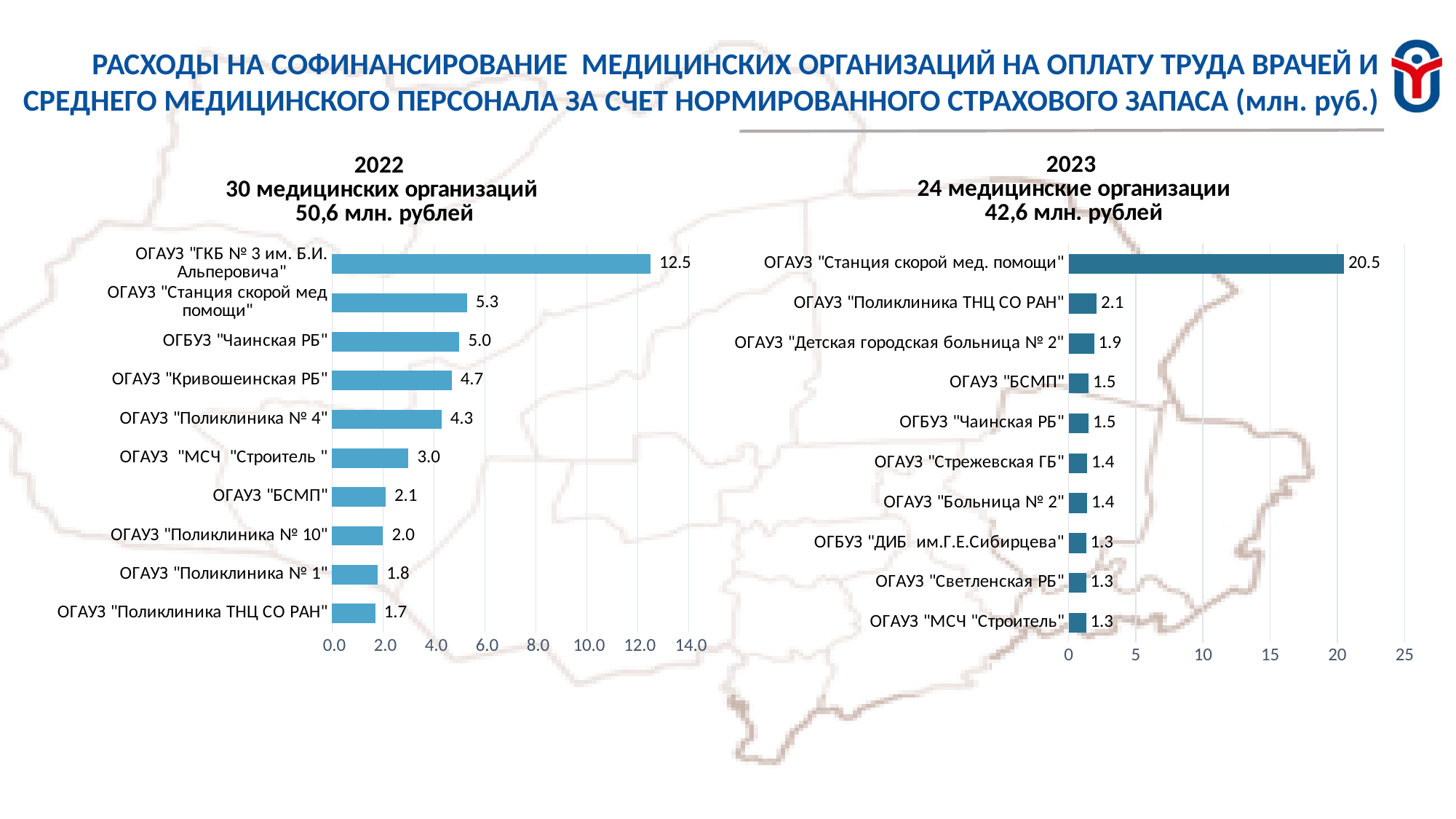
In the 2023 chart, what is the value for ОГАУЗ "Поликлиника ТНЦ СО РАН"? 2.1 In the 2023 chart, is the value for ОГАУЗ "Станция скорой мед. помощи" greater or less than 20? greater In the 2022 chart, what is the value for ОГАУЗ "Станция скорой мед помощи"? 5.3 According to the 2023 chart heading, how many medical organisations were covered in 2023? 24 In the 2022 chart, what is the difference between ОГБУЗ "Чаинская РБ" and ОГАУЗ "Кривошеинская РБ"? 0.3 In the 2022 chart, which organisation has the highest value? ОГАУЗ "ГКБ № 3 им. Б.И. Альперовича" In the 2022 chart, which is larger: ОГАУЗ "МСЧ "Строитель" or ОГАУЗ "БСМП"? ОГАУЗ "МСЧ "Строитель" In the 2023 chart, which organisation has the highest value? ОГАУЗ "Станция скорой мед. помощи" How many organisations are shown in the 2022 chart? 10 In the 2023 chart, what is the difference between ОГАУЗ "Станция скорой мед. помощи" and ОГАУЗ "Детская городская больница № 2"? 18.6 What kind of chart is used for the 2023 data? bar chart In the 2022 chart, which organisation has the lowest value? ОГАУЗ "Поликлиника ТНЦ СО РАН"